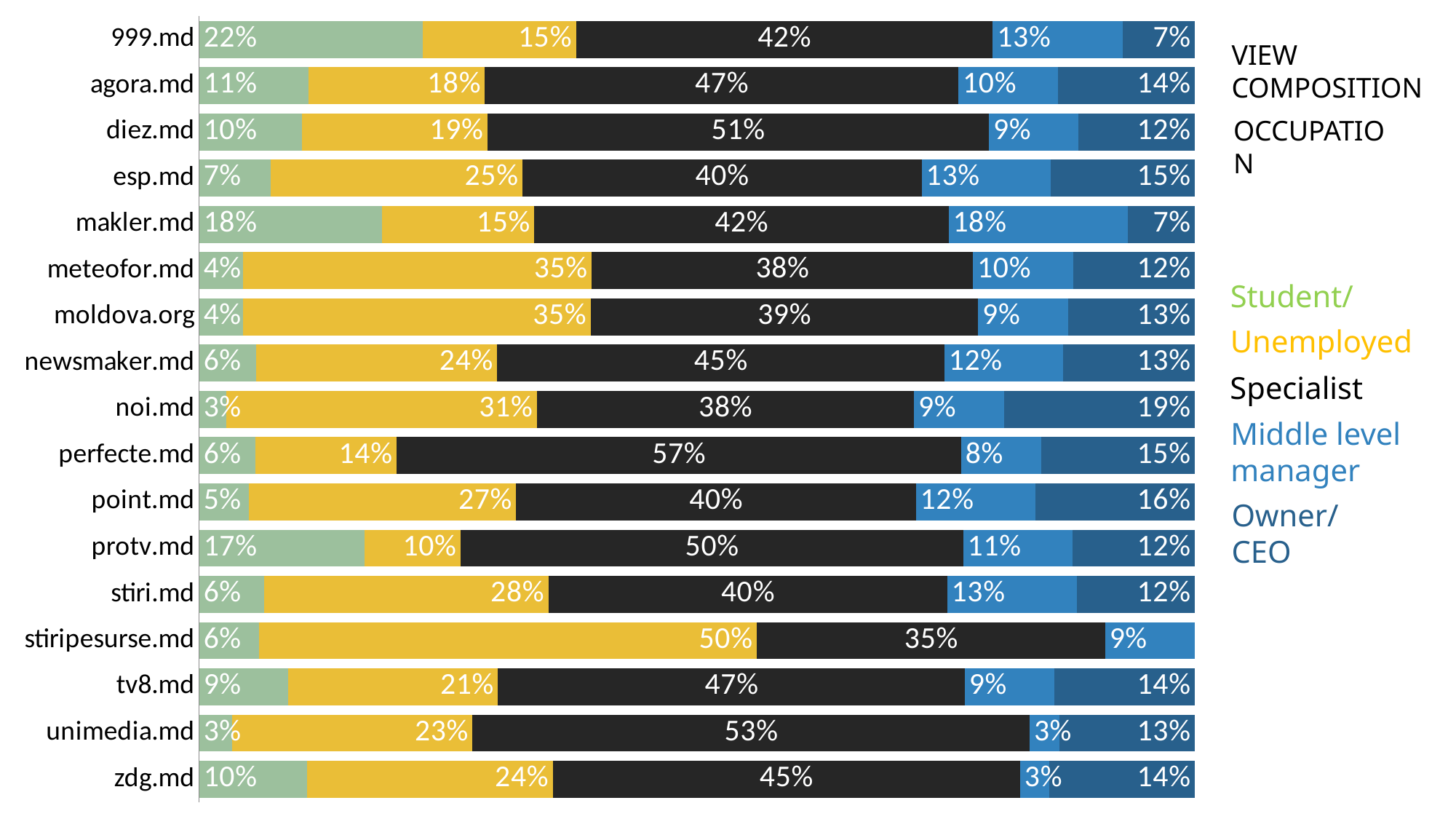
Which is larger: the Middle level manager share for makler.md or for agora.md? makler.md What is the Specialist share for perfecte.md? 57% Which website has the highest Specialist share? perfecte.md What colour represents the Specialist series? black What is the Owner/CEO share for noi.md? 19% Which website has the highest Student share? 999.md What is the Unemployed share for stiripesurse.md? 50% What is the difference between the Specialist share of diez.md and that of esp.md? 11% What type of chart is shown on the slide? stacked bar chart How many websites (categories) are listed on the chart? 17 What is the Student share for 999.md? 22% How many series does the legend list? 5